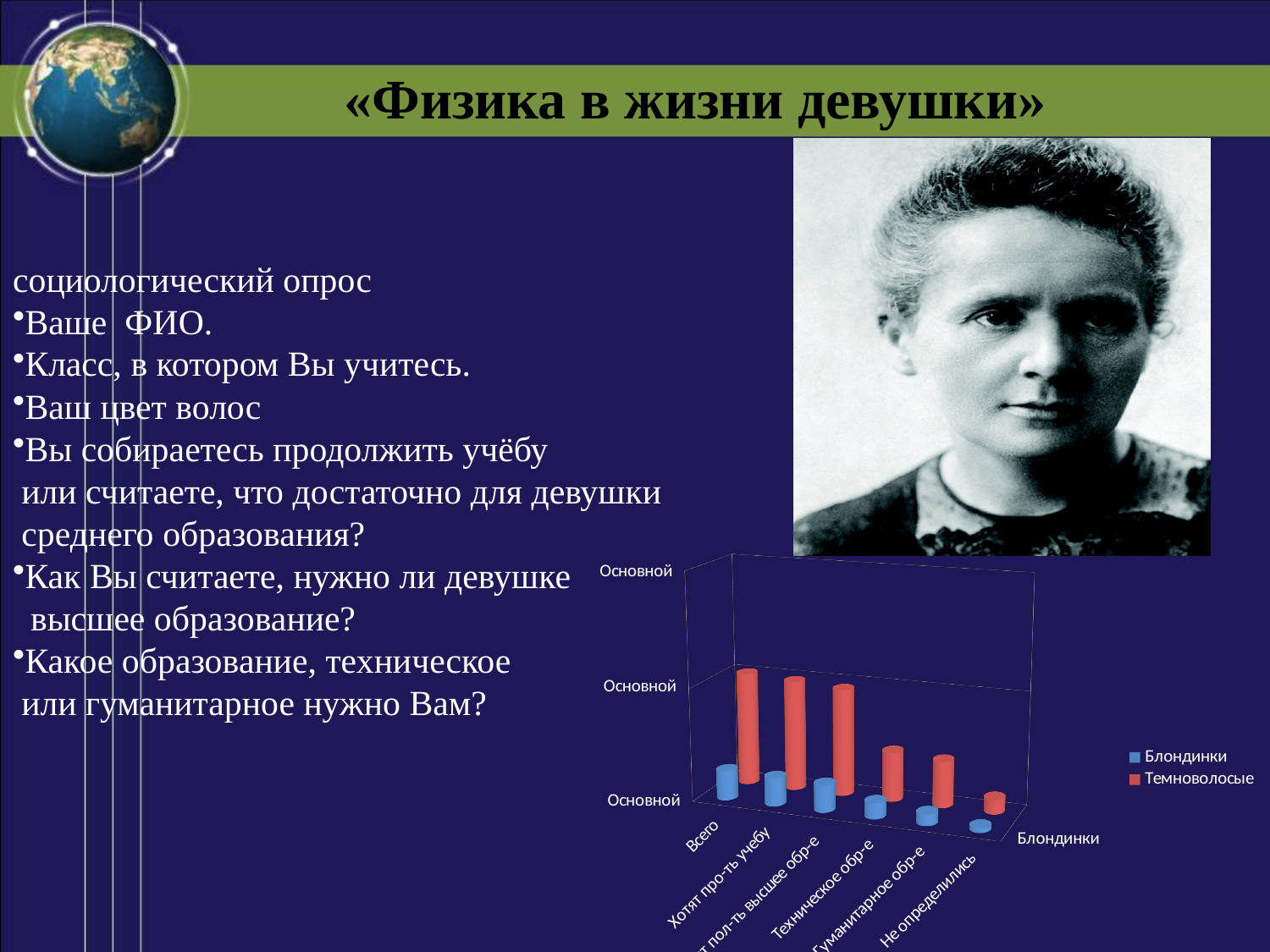
Which category has the lowest value for the Блондинки series? Не определились Do the values of the Темноволосые series generally rise or fall from left to right along the x axis? fall What kind of chart is shown on the slide? bar chart Which category has the lowest value for the Темноволосые series? Не определились Do the values of the Блондинки series generally rise or fall from left to right along the x axis? fall How many series does the chart legend list? 2 Which colour represents the Темноволосые series in the chart? red How many categories are shown along the x axis of the chart? 6 What are the two series named in the chart legend? Блондинки, Темноволосые For the category Всего, which series has the larger value, Блондинки or Темноволосые? Темноволосые For the Темноволосые series, is the value for Всего larger or smaller than the value for Гуманитарное обр-е? larger For the category Техническое обр-е, which series has the larger value, Блондинки or Темноволосые? Темноволосые